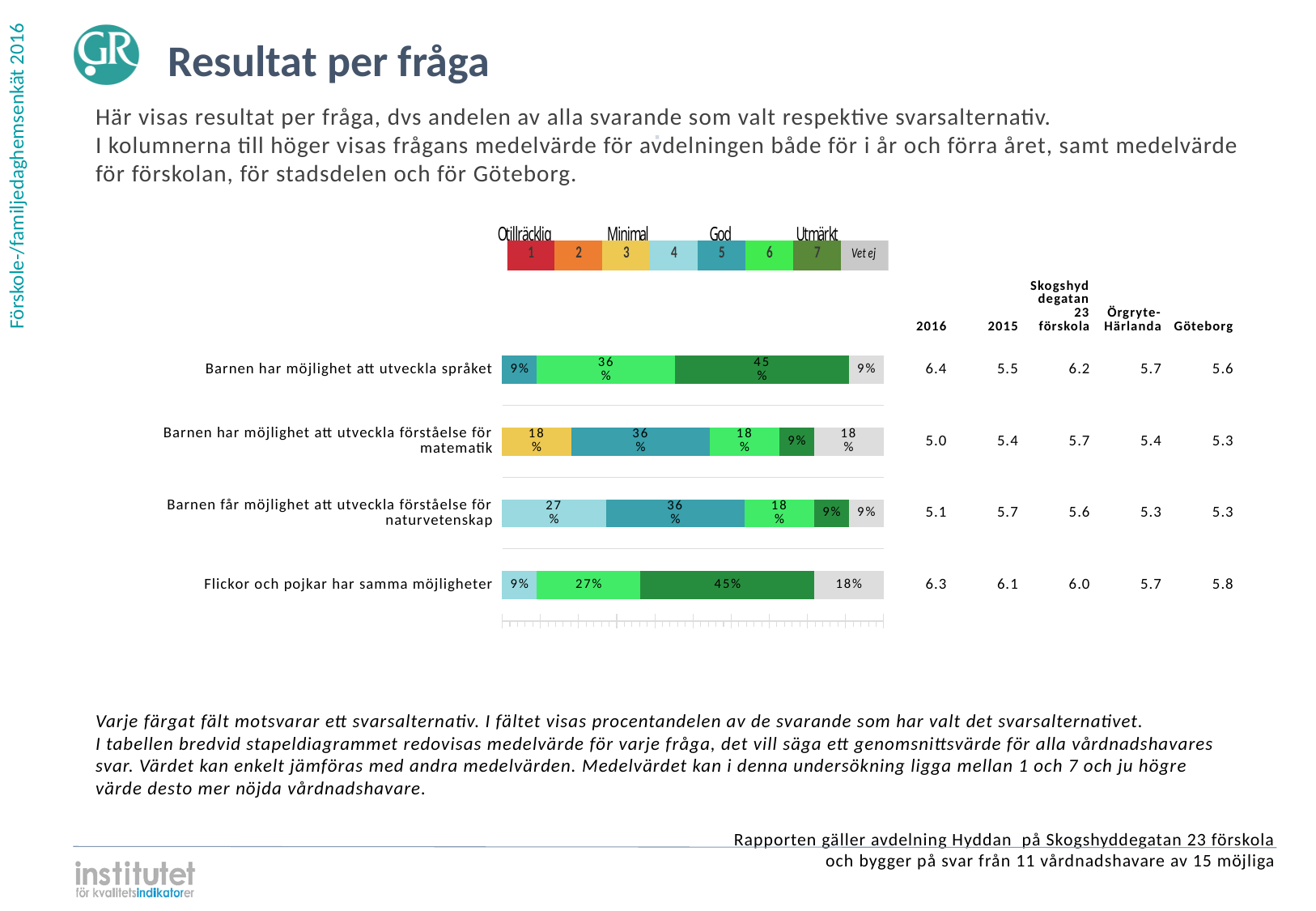
What is the difference in percentage points between the 'Utmärkt' (7) share for 'Barnen har möjlighet att utveckla språket' (45%) and for 'Barnen har möjlighet att utveckla förståelse för matematik' (9%)? 36 percentage points What kind of chart is shown on the slide? Stacked bar chart What percentage of respondents chose 'Utmärkt' (7) for 'Barnen har möjlighet att utveckla språket'? 45% What is the Göteborg mean value shown for 'Flickor och pojkar har samma möjligheter'? 5.8 What percentage chose answer 3 (yellow) for 'Barnen har möjlighet att utveckla förståelse för matematik'? 18% How many answer alternatives does the legend above the chart list? 8 How many questions (categories) are plotted in the bar chart? 4 What label does the legend give to the grey segment at the end of each bar? Vet ej What percentage chose answer 4 (light blue) for 'Barnen får möjlighet att utveckla förståelse för naturvetenskap'? 27% Which has a larger share of 'Utmärkt' (7) answers: 'Barnen har möjlighet att utveckla språket' or 'Barnen har möjlighet att utveckla förståelse för matematik'? Barnen har möjlighet att utveckla språket What percentage chose 'Vet ej' for 'Flickor och pojkar har samma möjligheter'? 18% What is the 2016 mean value shown for 'Barnen har möjlighet att utveckla språket'? 6.4